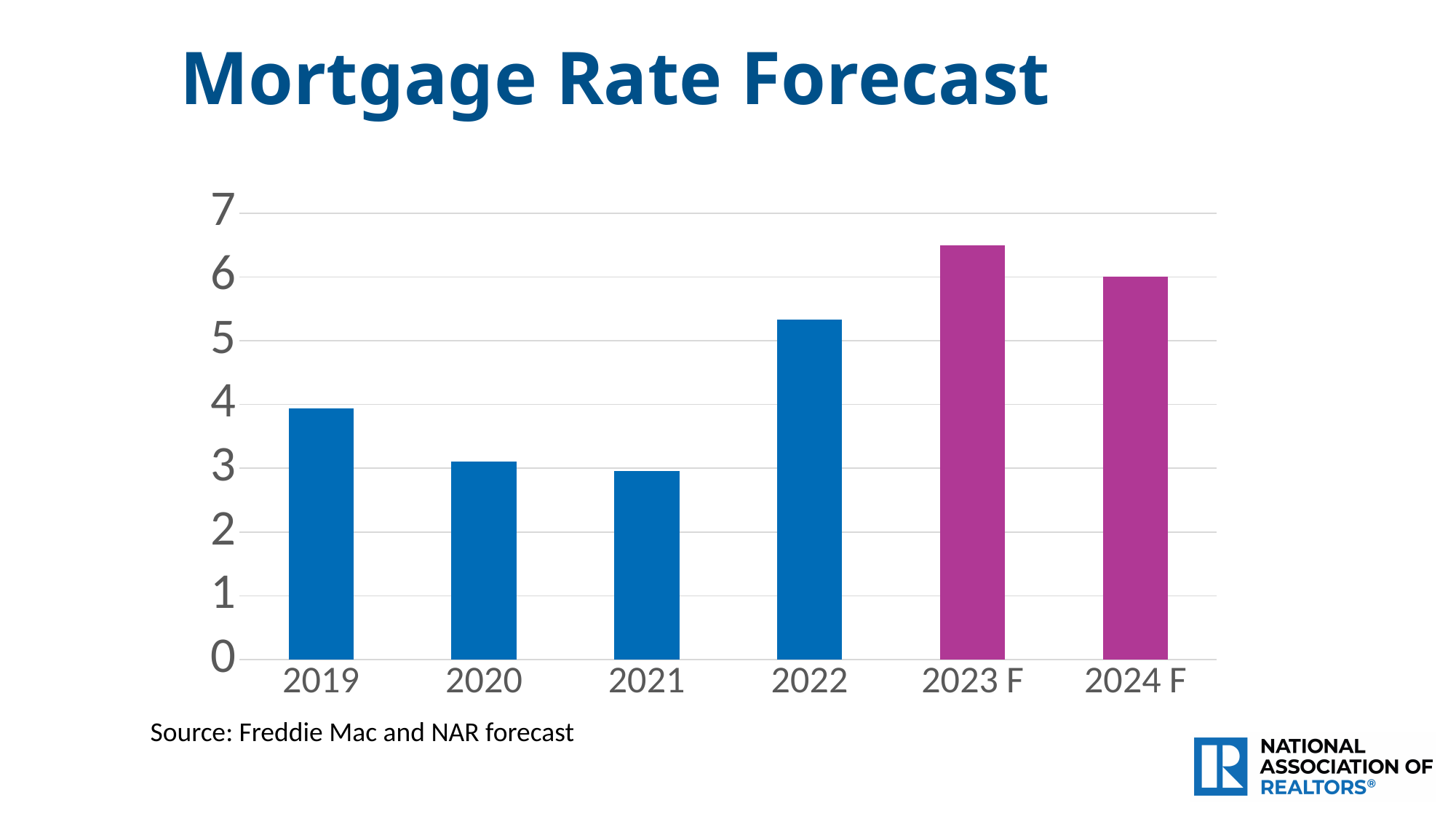
Is the value for 2023 F greater or less than 6? greater What is the title of the chart? Mortgage Rate Forecast What kind of chart is shown on the slide? bar chart How many years are shown on the x axis of the chart? 6 Is the value for 2022 greater or less than 5? greater Which year has the highest mortgage rate in the chart? 2023 F Do the values rise or fall from 2021 to 2023 F? rise Is the value for 2024 F greater or less than 5? greater Which is larger, the value for 2023 F or the value for 2024 F? 2023 F Which is larger, the value for 2022 or the value for 2019? 2022